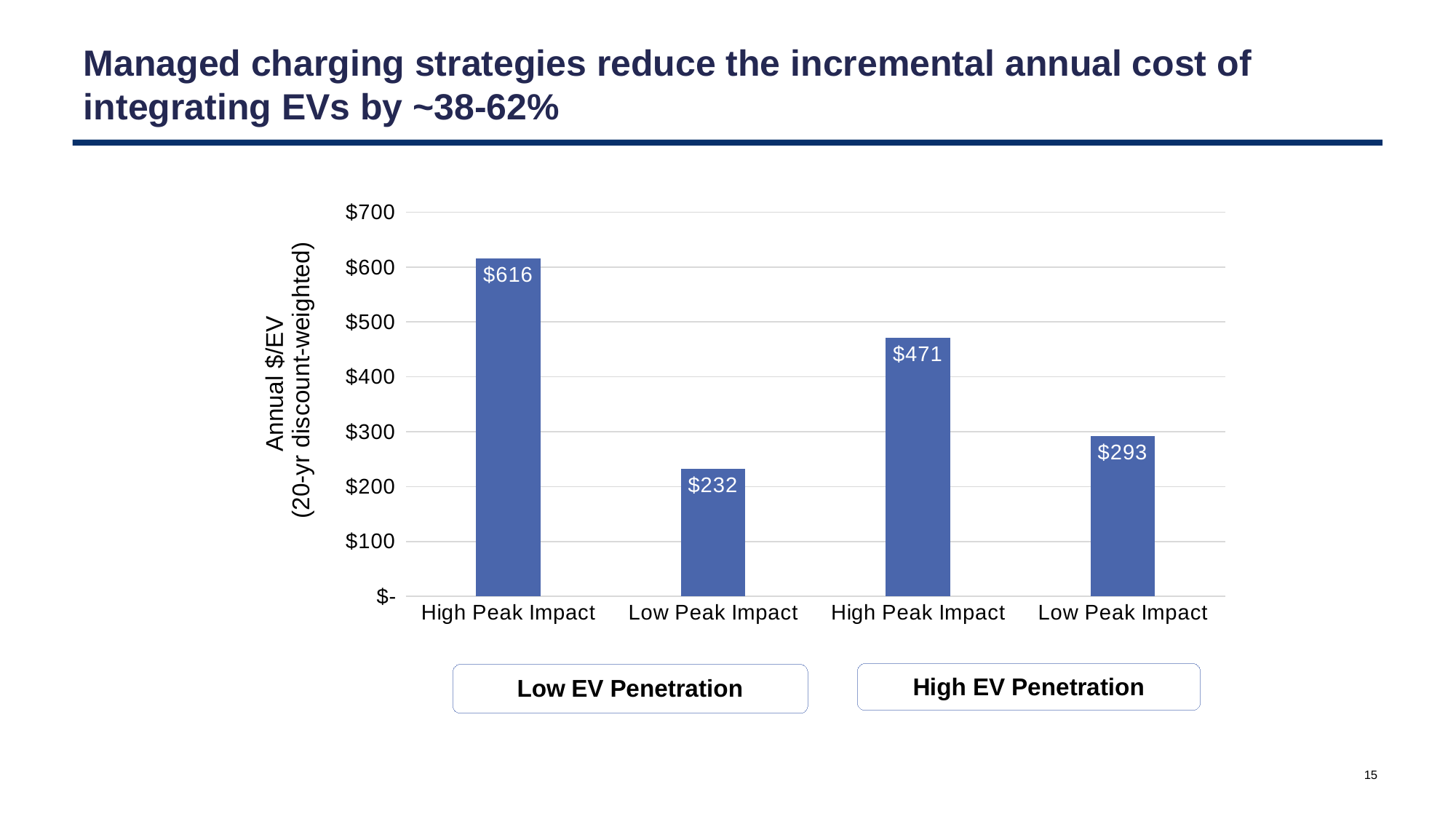
What is the value for High Peak Impact under High EV Penetration? $471 Which is larger: the Low Peak Impact value under Low EV Penetration or under High EV Penetration? High EV Penetration What is the difference between the High Peak Impact and Low Peak Impact values under Low EV Penetration? $384 What is the label of the vertical axis? Annual $/EV (20-yr discount-weighted) What kind of chart is shown on the slide? Bar chart What is the value for Low Peak Impact under Low EV Penetration? $232 What is the value for High Peak Impact under Low EV Penetration? $616 Which bar has the highest value? High Peak Impact (Low EV Penetration) Which bar has the lowest value? Low Peak Impact (Low EV Penetration) How many bars are plotted in the chart? 4 What is the value for Low Peak Impact under High EV Penetration? $293 What is the difference between the High Peak Impact and Low Peak Impact values under High EV Penetration? $178